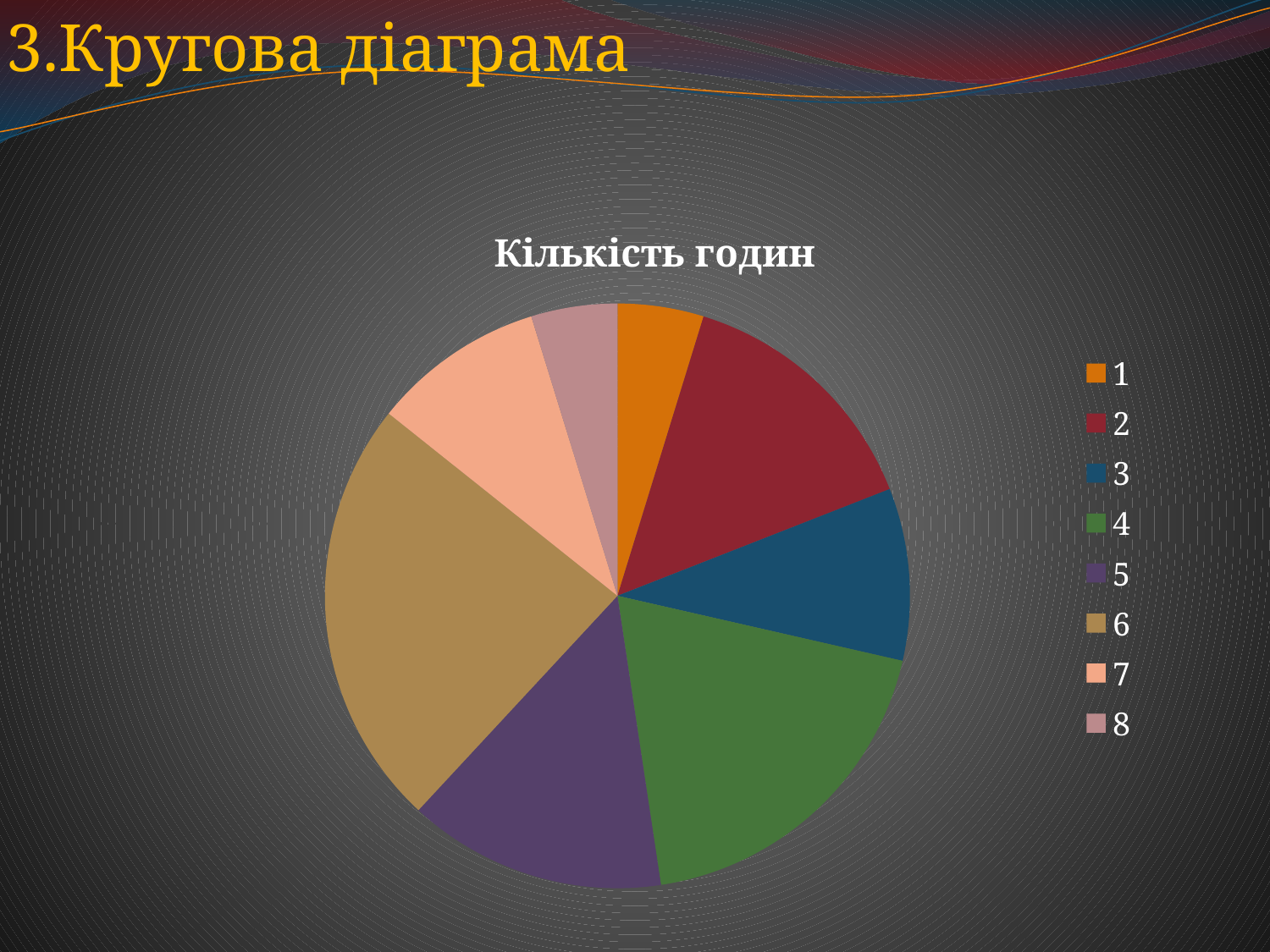
Which slice is larger, category 4 or category 5? 4 What kind of chart is shown on the slide? pie chart What colour is the slice for category 6 in the legend? tan (brownish gold) Which category has the largest slice of the pie? 6 How many entries does the legend list? 8 Which slice is larger, category 2 or category 3? 2 How many slices does the pie chart have? 8 What is the title of the chart? Кількість годин Which slice is larger, category 6 or category 4? 6